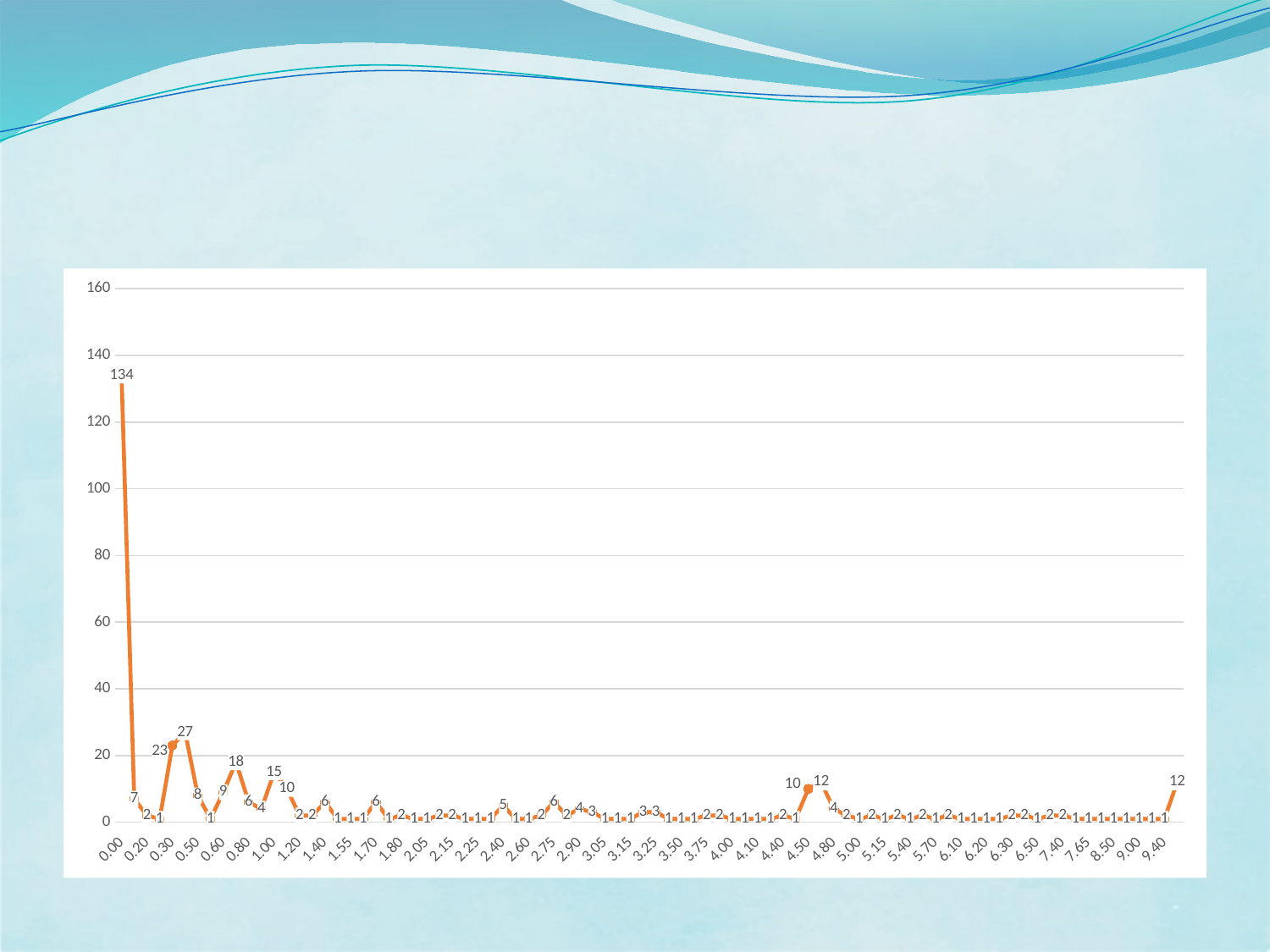
Which is larger, the value at x = 0.00 or the value at x = 9.40? 0.00 Which x-axis category has the highest value? 0.00 What is the maximum value shown on the y-axis? 160 What type of chart is shown on the slide? line chart Is the value at x = 9.40 greater or less than 20? less What colour is the plotted line? orange Is the value at x = 0.00 greater or less than 120? greater What is the highest value labelled on the line? 134 What is the difference between the highest labelled value (134) and the second-highest labelled value (27)? 107 What is the value plotted at x = 0.00? 134 What is the second-highest value labelled on the line? 27